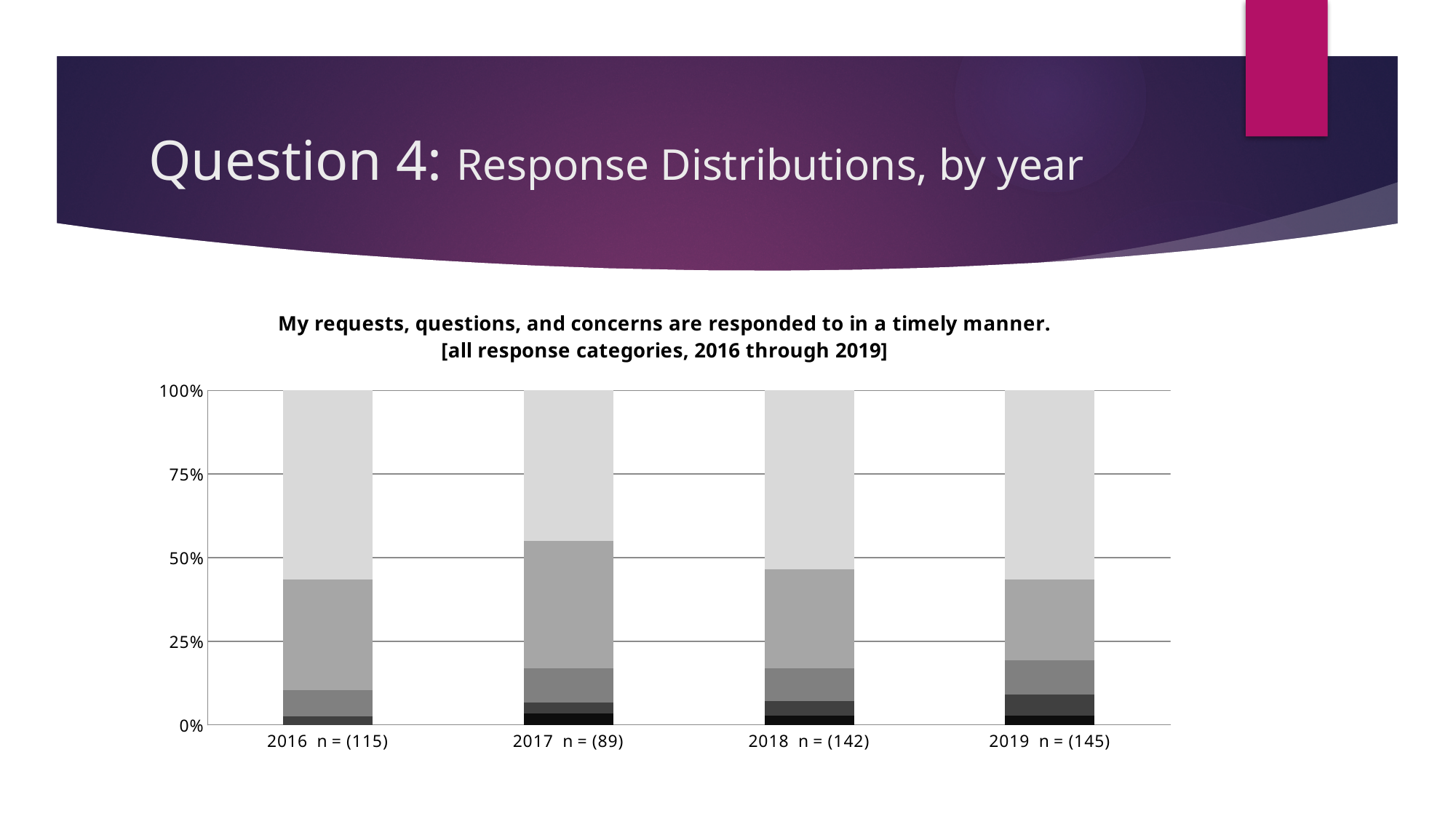
What is the difference between the sample sizes for 2019 and 2017? 56 How many years (bars) are shown on the x axis of the chart? 4 Is the light gray (top) segment of the 2016 bar greater or less than 50% of the bar? greater What is the first line of the chart title? My requests, questions, and concerns are responded to in a timely manner. What is the sample size (n) shown for 2019? 145 What kind of chart is shown on the slide? Stacked bar chart Is the light gray (top) segment of the 2017 bar greater or less than 50% of the bar? less What is the total height of each stacked bar on the y axis? 100% Which year has the largest sample size (n)? 2019 Which year has the largest medium gray (second from top) segment? 2017 Which year has the smallest sample size (n)? 2017 What is the sample size (n) shown for 2017? 89